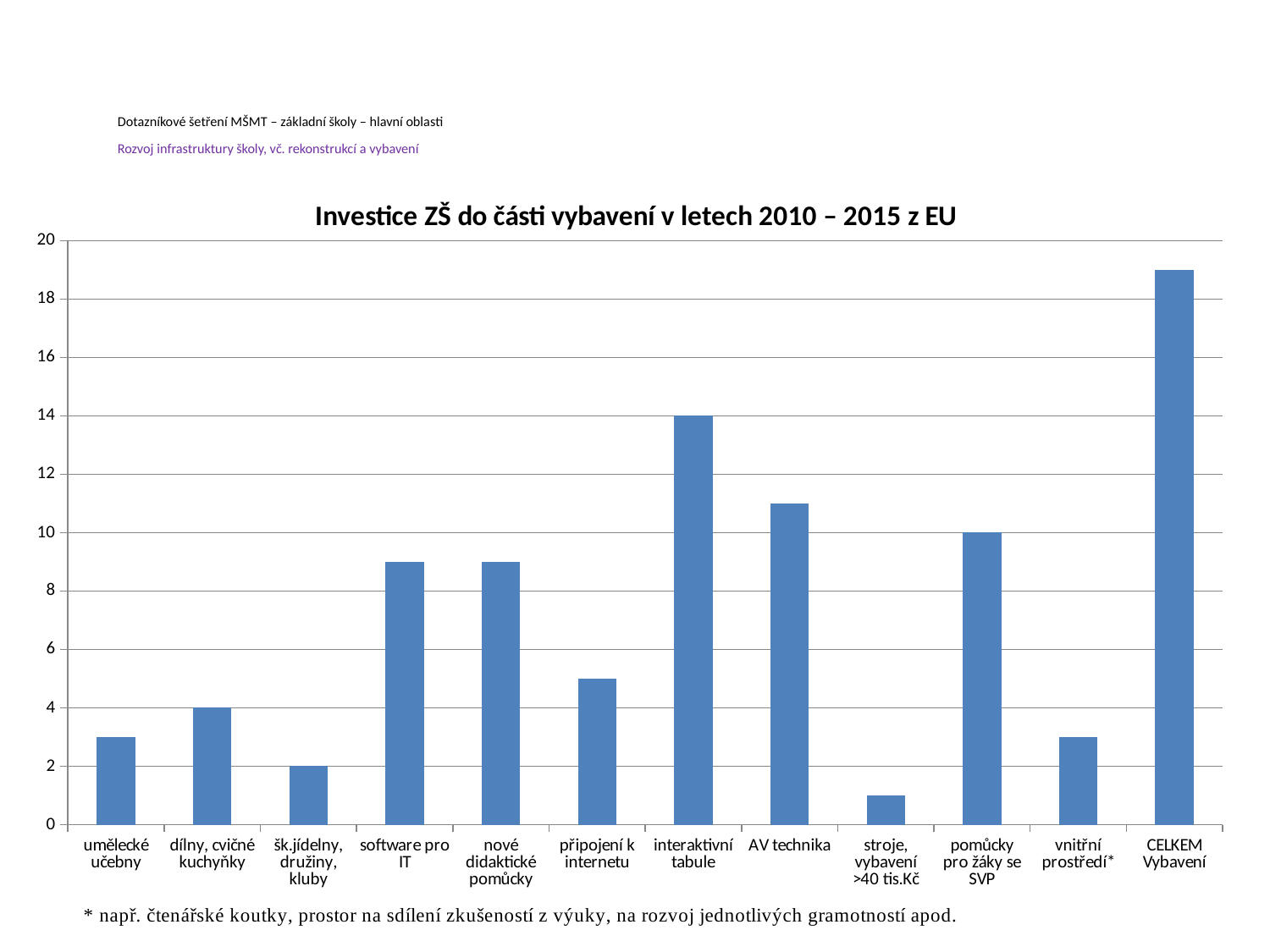
Which category has the lowest bar in the chart? stroje, vybavení >40 tis.Kč Is the value for software pro IT greater or less than 10? less What is the value for interaktivní tabule? 14 Which category has the highest bar in the chart? CELKEM Vybavení What is the value for dílny, cvičné kuchyňky? 4 What is the value for pomůcky pro žáky se SVP? 10 What kind of chart is shown on the slide? bar chart What is the difference between the values for interaktivní tabule and pomůcky pro žáky se SVP? 4 Is the value for CELKEM Vybavení greater or less than 18? greater Which is larger, the value for interaktivní tabule or the value for AV technika? interaktivní tabule How many categories are shown on the x axis of the chart? 12 What is the title of the chart? Investice ZŠ do části vybavení v letech 2010 – 2015 z EU